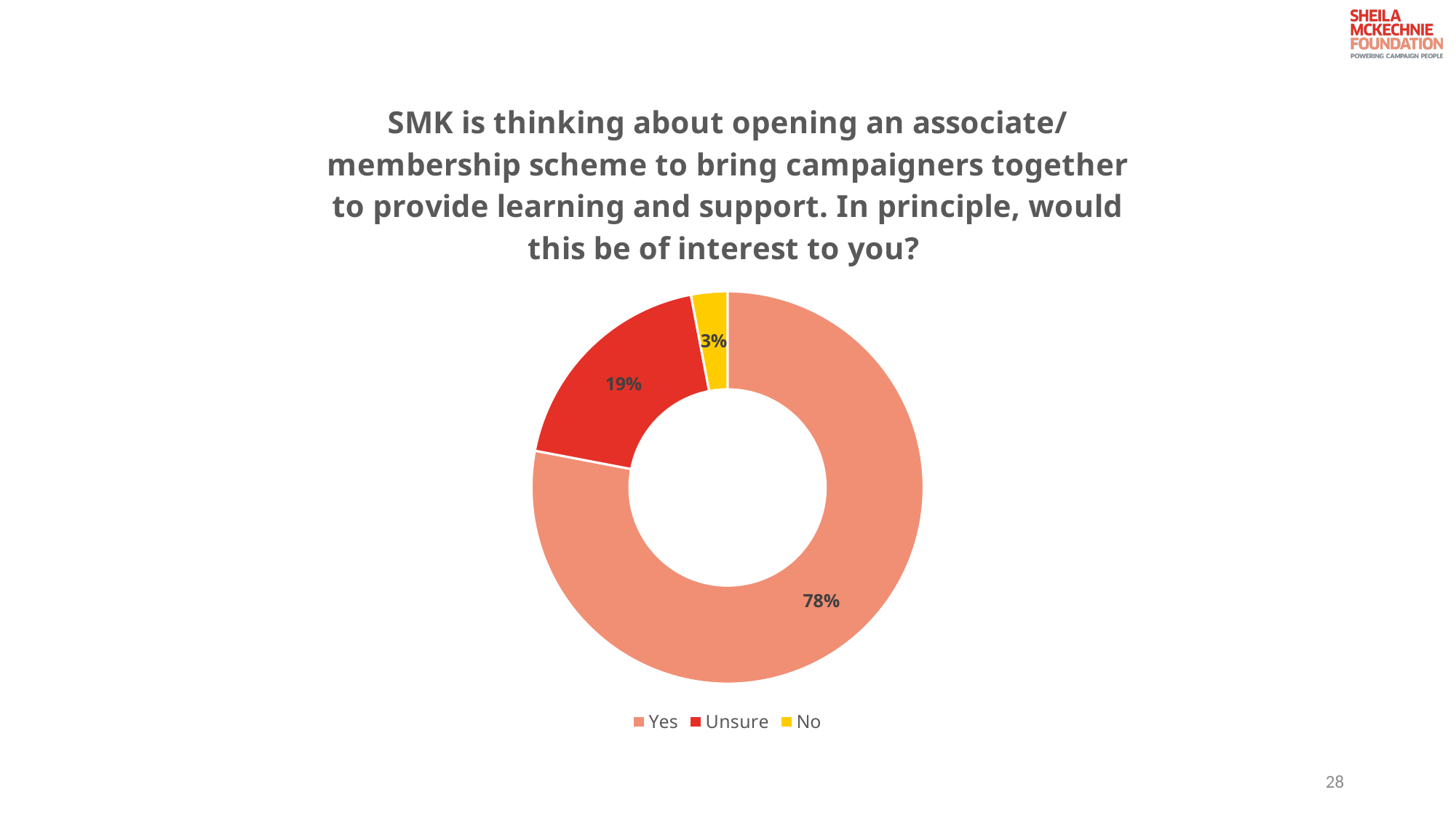
What colour is the Unsure slice? Red Which response has the largest share of the chart? Yes Which is larger, the share for Unsure or the share for No? Unsure What percentage of respondents answered Yes? 78% What are the three legend entries listed below the chart? Yes, Unsure, No What percentage of respondents answered No? 3% What is the difference in percentage points between Unsure and No? 16 What is the difference in percentage points between Yes and Unsure? 59 What kind of chart is shown on the slide? Pie chart (doughnut) What percentage of respondents answered Unsure? 19% Which response has the smallest share of the chart? No How many response categories are shown in the chart? 3